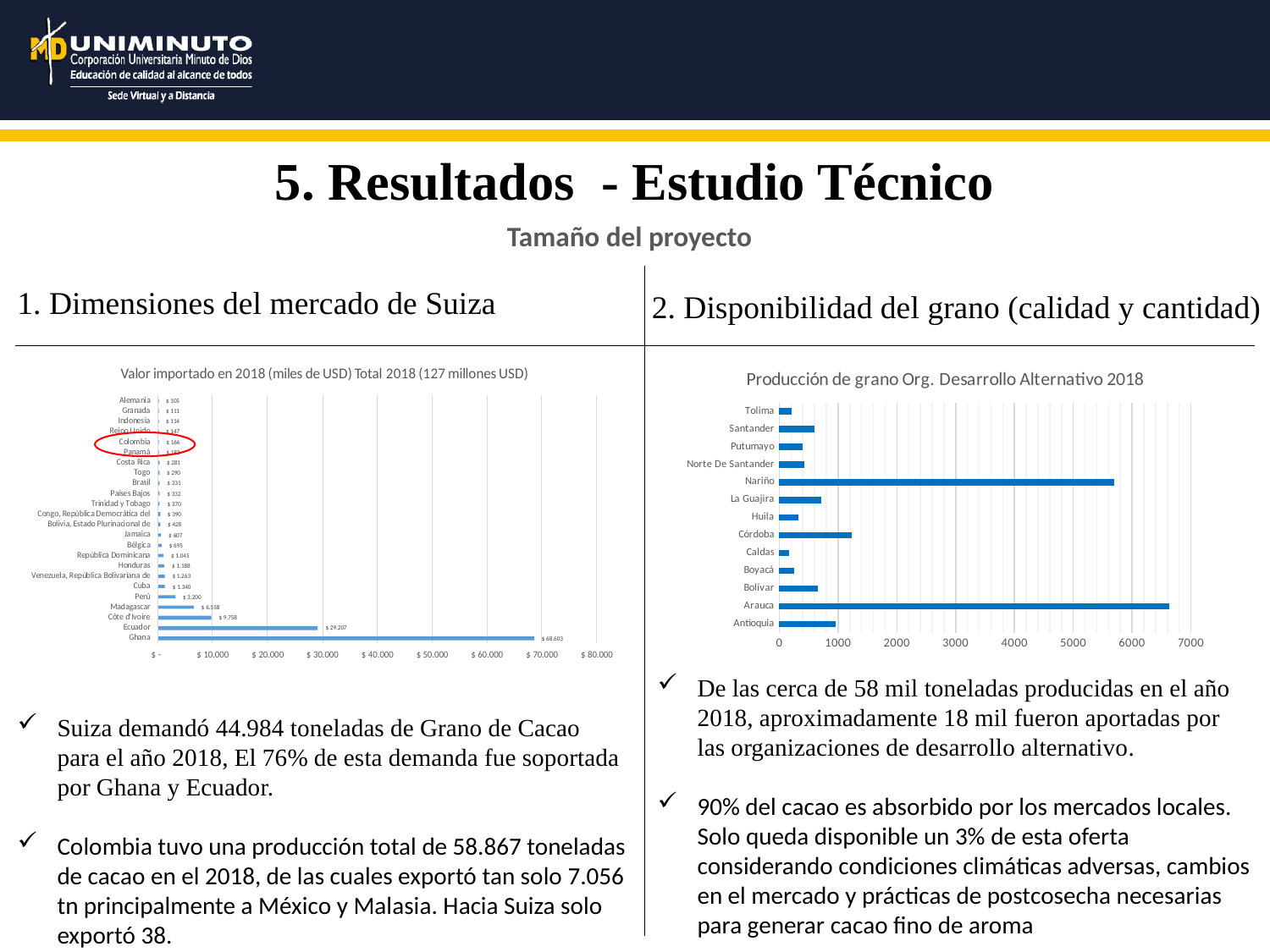
In the left chart (Valor importado en 2018), what is the difference between the values for Ghana and Ecuador? $ 39.396 In the left chart (Valor importado en 2018), which country has the lowest imported value? Alemania In the left chart (Valor importado en 2018), which country has the highest imported value? Ghana In the right chart (Producción de grano Org. Desarrollo Alternativo 2018), is the value for Nariño greater or less than 5000? greater How many countries are shown in the left chart (Valor importado en 2018)? 24 In the right chart (Producción de grano Org. Desarrollo Alternativo 2018), is the value for Tolima greater or less than 1000? less In the left chart (Valor importado en 2018), what is the value for Ghana? $ 68.603 In the left chart (Valor importado en 2018), which is larger, the value for Perú or the value for Madagascar? Madagascar In the left chart (Valor importado en 2018), what is the value for Ecuador? $ 29.207 What kind of chart is the right chart (Producción de grano Org. Desarrollo Alternativo 2018)? bar chart In the right chart (Producción de grano Org. Desarrollo Alternativo 2018), which department has the highest production? Arauca How many departments are shown in the right chart (Producción de grano Org. Desarrollo Alternativo 2018)? 13